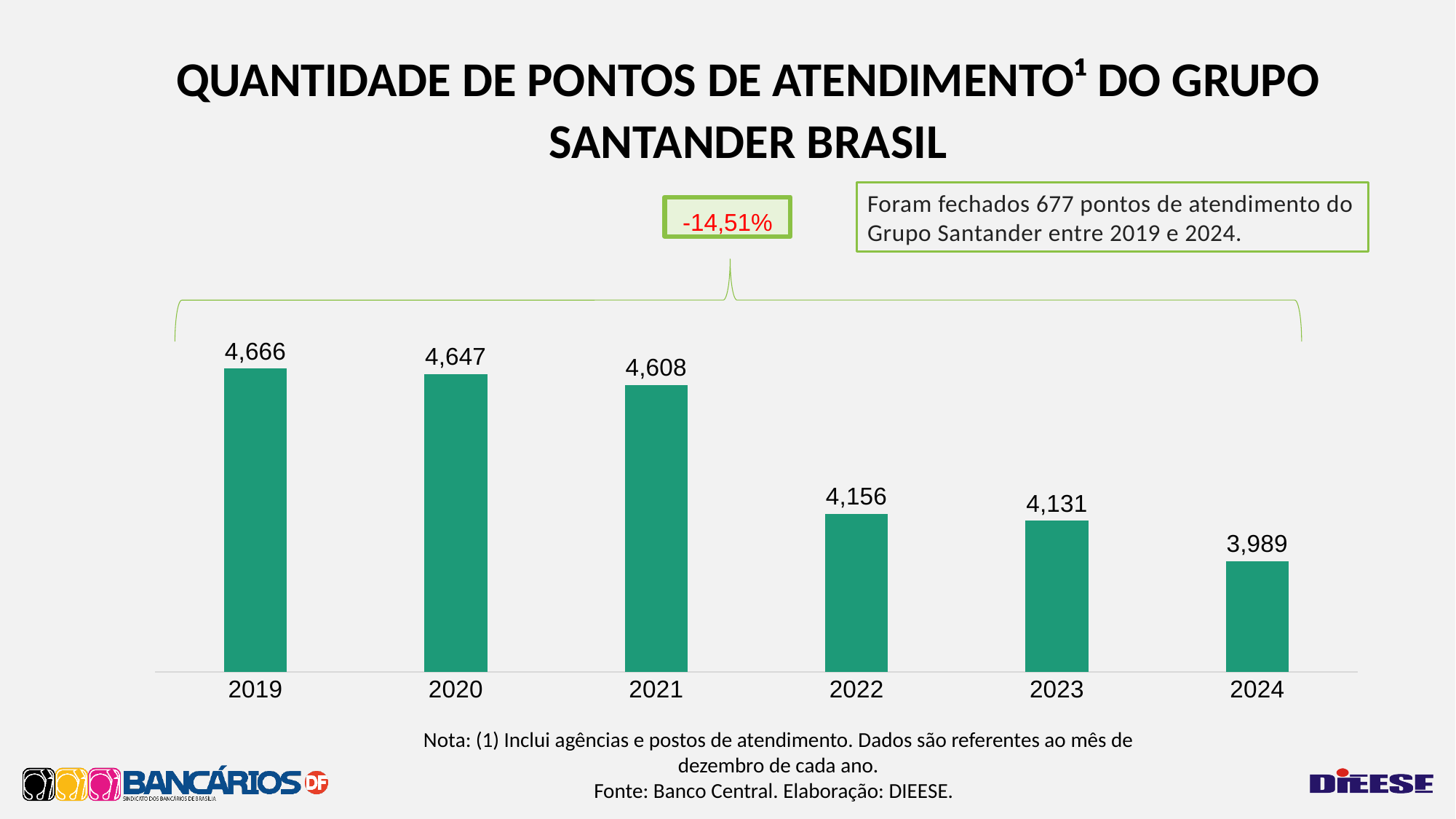
What kind of chart is this? bar chart Which year has the highest number of service points? 2019 What is the difference between the values for 2021 and 2022? 452 Which year has the lowest number of service points? 2024 Which is larger, the value for 2020 or the value for 2023? 2020 Do the values rise or fall from 2019 to 2024? fall What is the number of service points for 2024? 3,989 What percentage change is shown in the highlighted box above the chart? -14,51% What is the number of service points for 2019? 4,666 What is the difference between the values for 2019 and 2024? 677 How many years are shown on the chart? 6 What is the number of service points for 2022? 4,156